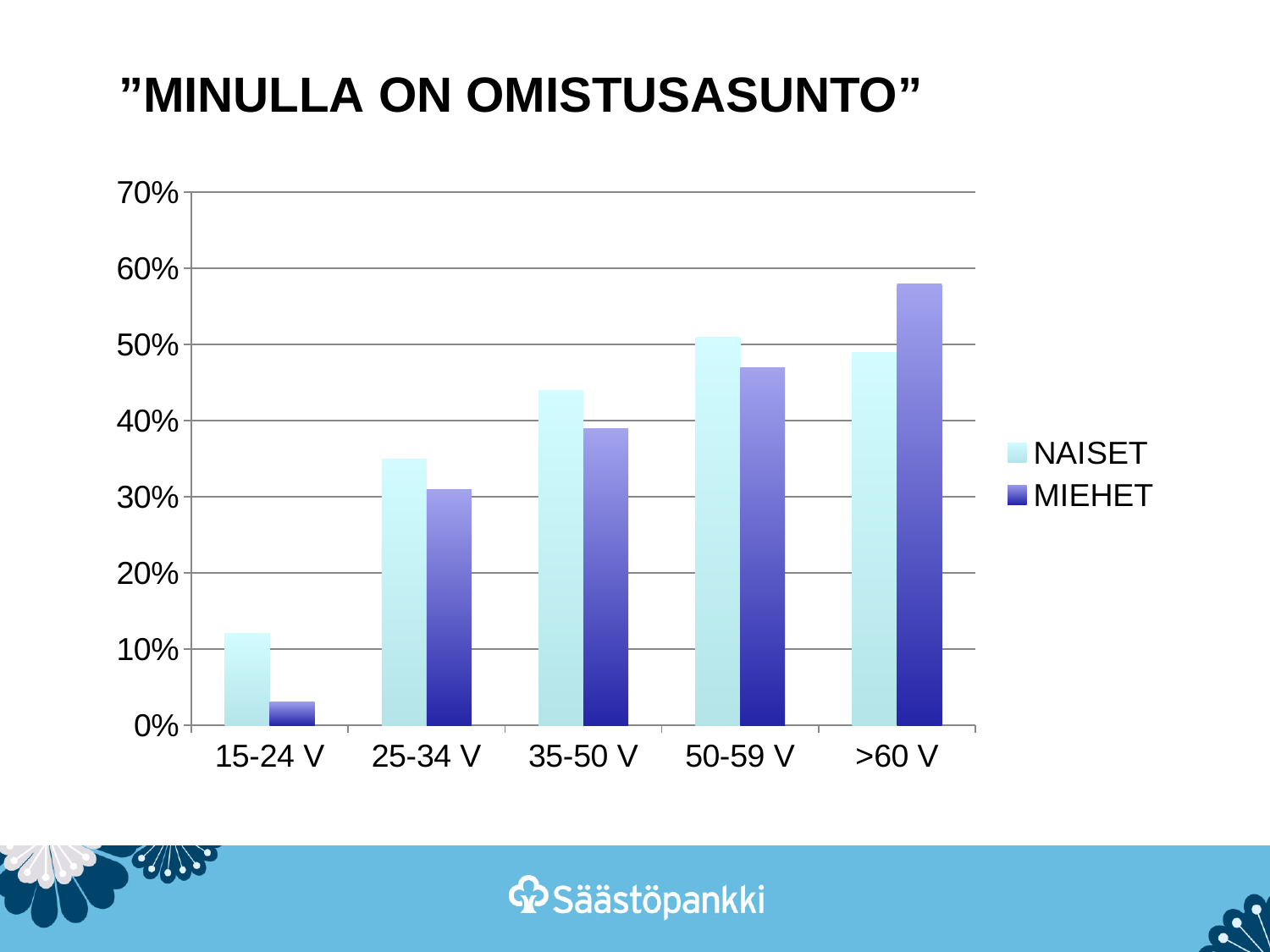
How many series does the legend list? 2 Is the value for MIEHET in the >60 V group greater or less than 50%? greater Is the value for NAISET in the 35-50 V group greater or less than 40%? greater What kind of chart is shown on the slide? bar chart Which age group has the highest value for MIEHET? >60 V Is the value for MIEHET in the 15-24 V group greater or less than 10%? less How many age groups are shown on the x axis? 5 What is the title of the chart? "MINULLA ON OMISTUSASUNTO" Which age group has the lowest value for NAISET? 15-24 V Which age group has the lowest value for MIEHET? 15-24 V In the 15-24 V group, which series has the larger value, NAISET or MIEHET? NAISET In the >60 V group, which series has the larger value, NAISET or MIEHET? MIEHET